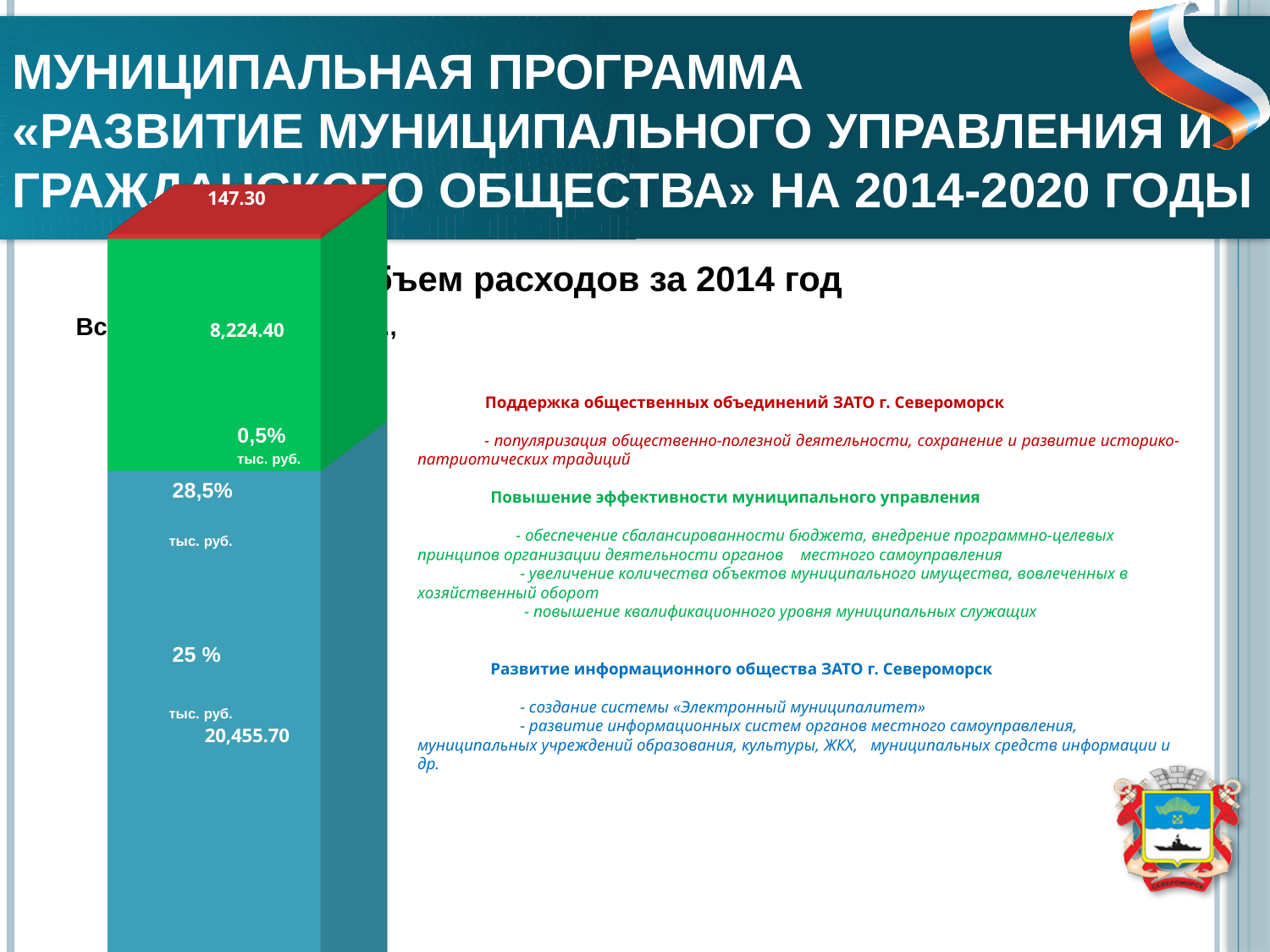
Which is larger, the green segment or the blue segment of the stacked bar? the blue segment What value is printed on the green (middle) segment of the stacked bar? 8,224.40 What is the total of the three segments in the stacked bar? 28,827.40 How many segments make up the stacked bar? 3 What colour is the segment with the value 147.30? red What is the difference between the blue segment (20,455.70) and the green segment (8,224.40)? 12,231.30 Which segment of the stacked bar has the smallest value? the red (top) segment, 147.30 What is the difference between the green segment (8,224.40) and the red segment (147.30)? 8,077.10 Which segment of the stacked bar has the largest value? the blue (bottom) segment, 20,455.70 What value is printed on the blue (bottom) segment of the stacked bar? 20,455.70 What value is printed on the red (top) segment of the stacked bar? 147.30 What kind of chart is shown on the left of the slide? stacked bar chart